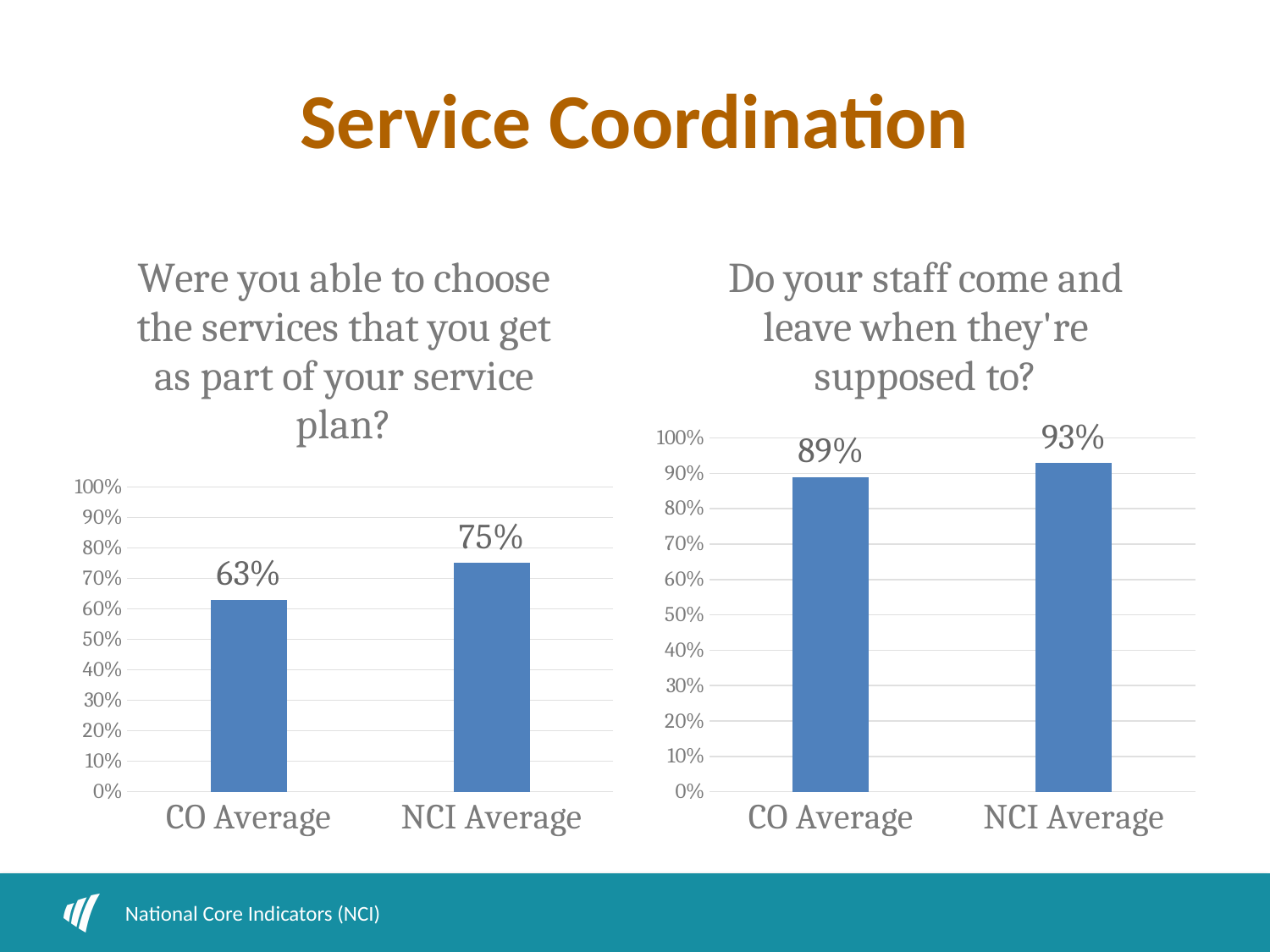
In the right chart, what is the difference between the NCI Average and the CO Average? 4% In the left chart ("Were you able to choose the services..."), what is the value for NCI Average? 75% How many categories are shown in the left chart? 2 In the right chart, is the value for CO Average greater or less than 80%? greater What is the title of the slide containing the two charts? Service Coordination In the left chart, what is the difference between the NCI Average and the CO Average? 12% In the right chart ("Do your staff come and leave when they're supposed to?"), what is the value for NCI Average? 93% What kind of chart is the right chart? Bar chart In the left chart, which category has the higher value? NCI Average In the left chart ("Were you able to choose the services that you get as part of your service plan?"), what is the value for CO Average? 63% In the right chart ("Do your staff come and leave when they're supposed to?"), what is the value for CO Average? 89% In the right chart, which category has the lower value? CO Average